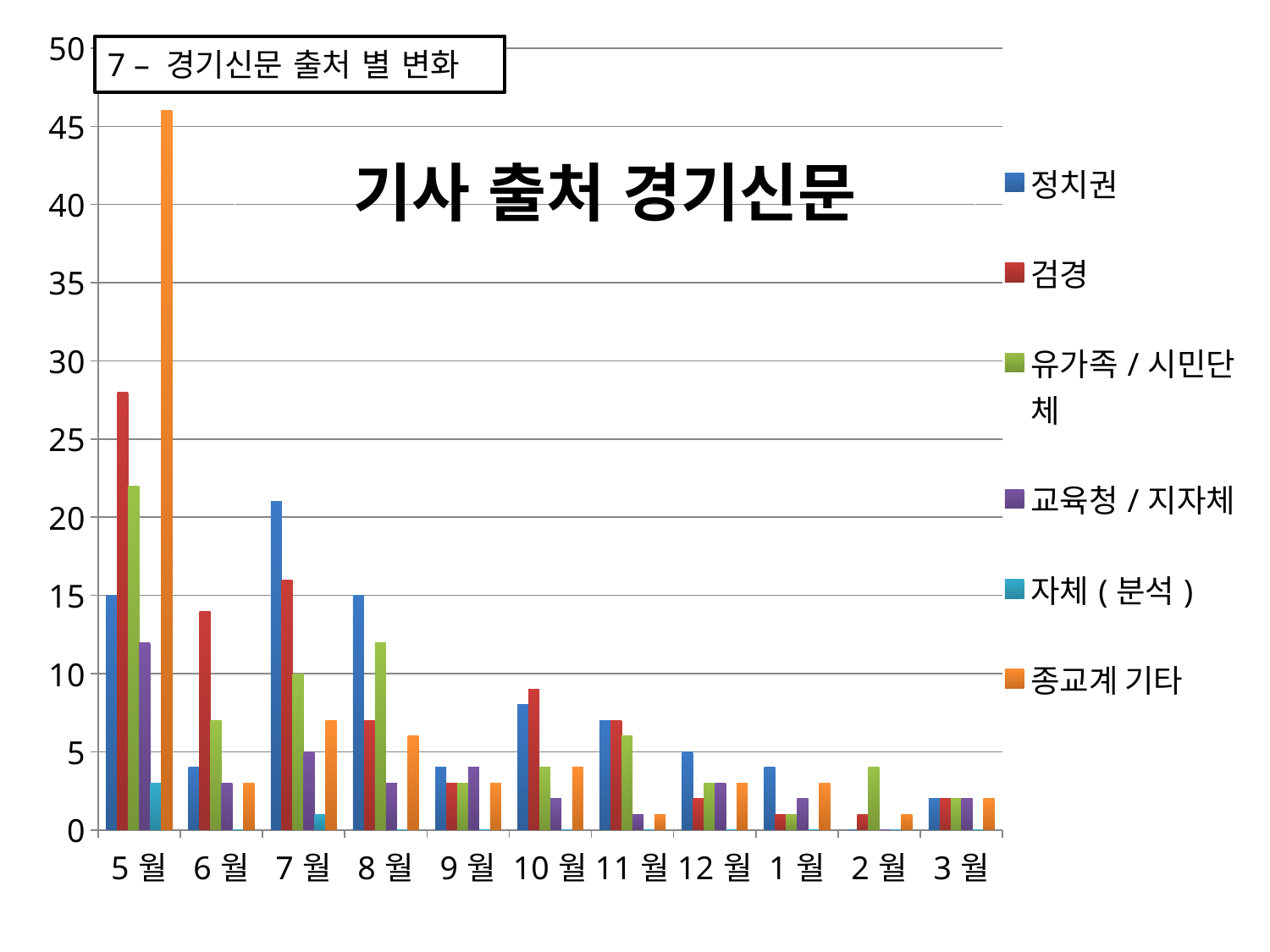
Is the value for 종교계 기타 in 5 월 greater or less than 40? greater Is the value for 검경 in 5 월 greater or less than 25? greater Which series has the tallest bar in the whole chart? 종교계 기타 Is the value for 검경 in 6 월 greater or less than 10? greater In 5 월, which is larger: 검경 or 정치권? 검경 How many series does the legend list? 6 How many months are shown on the x axis? 11 What is the title of the chart? 기사 출처 경기신문 In 7 월, which is larger: 정치권 or 검경? 정치권 In which month does 종교계 기타 reach its highest value? 5 월 What kind of chart is shown on the slide? bar chart